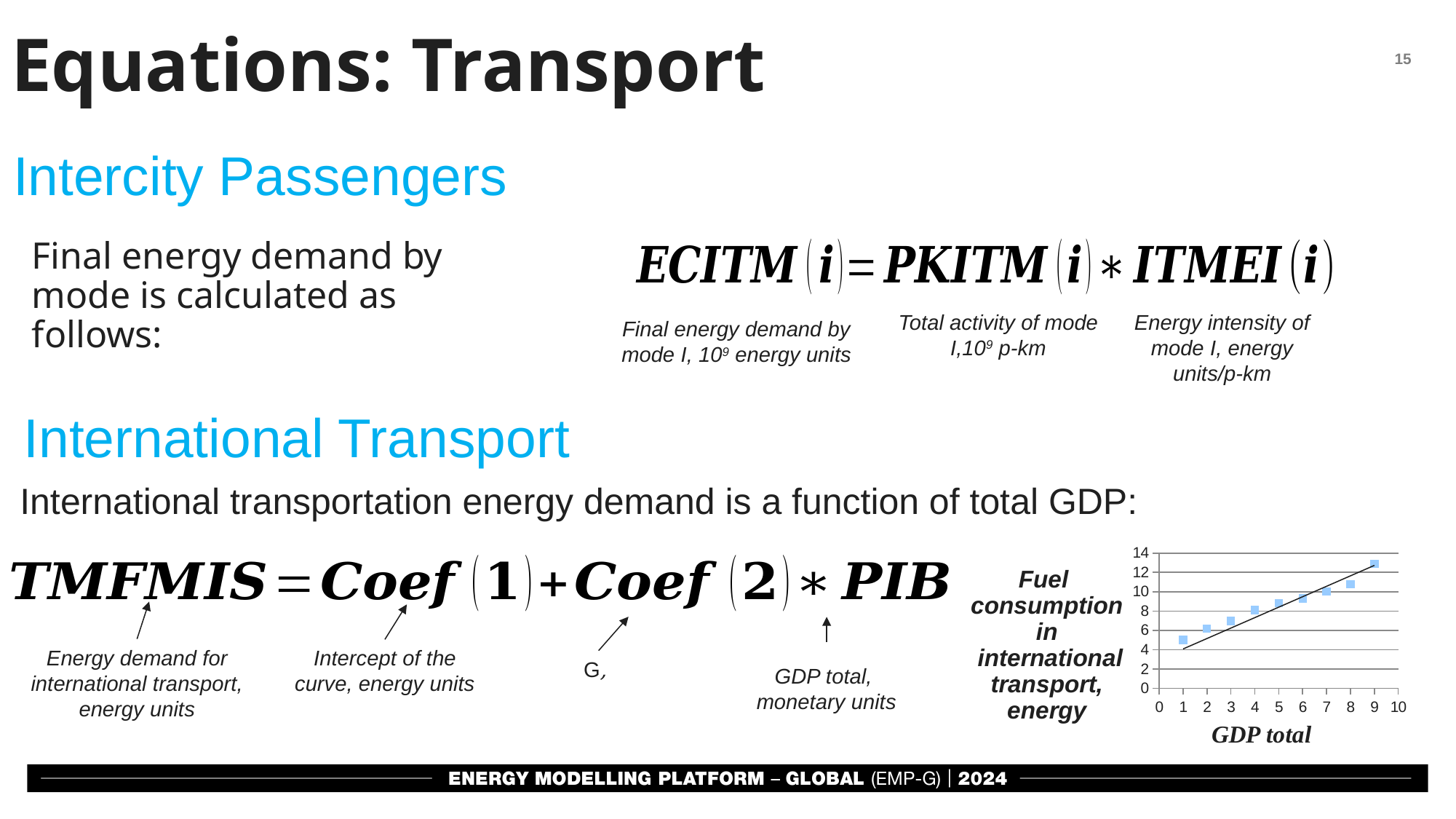
In the scatter chart, is the fuel consumption value at GDP total 7 greater or less than 8? greater In the scatter chart, what is the highest value shown on the y axis? 14 In the scatter chart, at which GDP total value is fuel consumption lowest? 1 In the scatter chart, do the values rise or fall as GDP total increases? rise In the scatter chart, is the fuel consumption value at GDP total 9 greater or less than 12? greater In the scatter chart, what is the label of the y axis? Fuel consumption in international transport, energy In the scatter chart, which has the larger fuel consumption value: GDP total 8 or GDP total 2? GDP total 8 In the scatter chart, at which GDP total value is fuel consumption highest? 9 In the scatter chart, is the fuel consumption value at GDP total 1 greater or less than 6? less In the scatter chart, what is the label of the x axis? GDP total What kind of chart is shown at the bottom right of the slide? scatter chart In the scatter chart, how many data points are plotted? 9